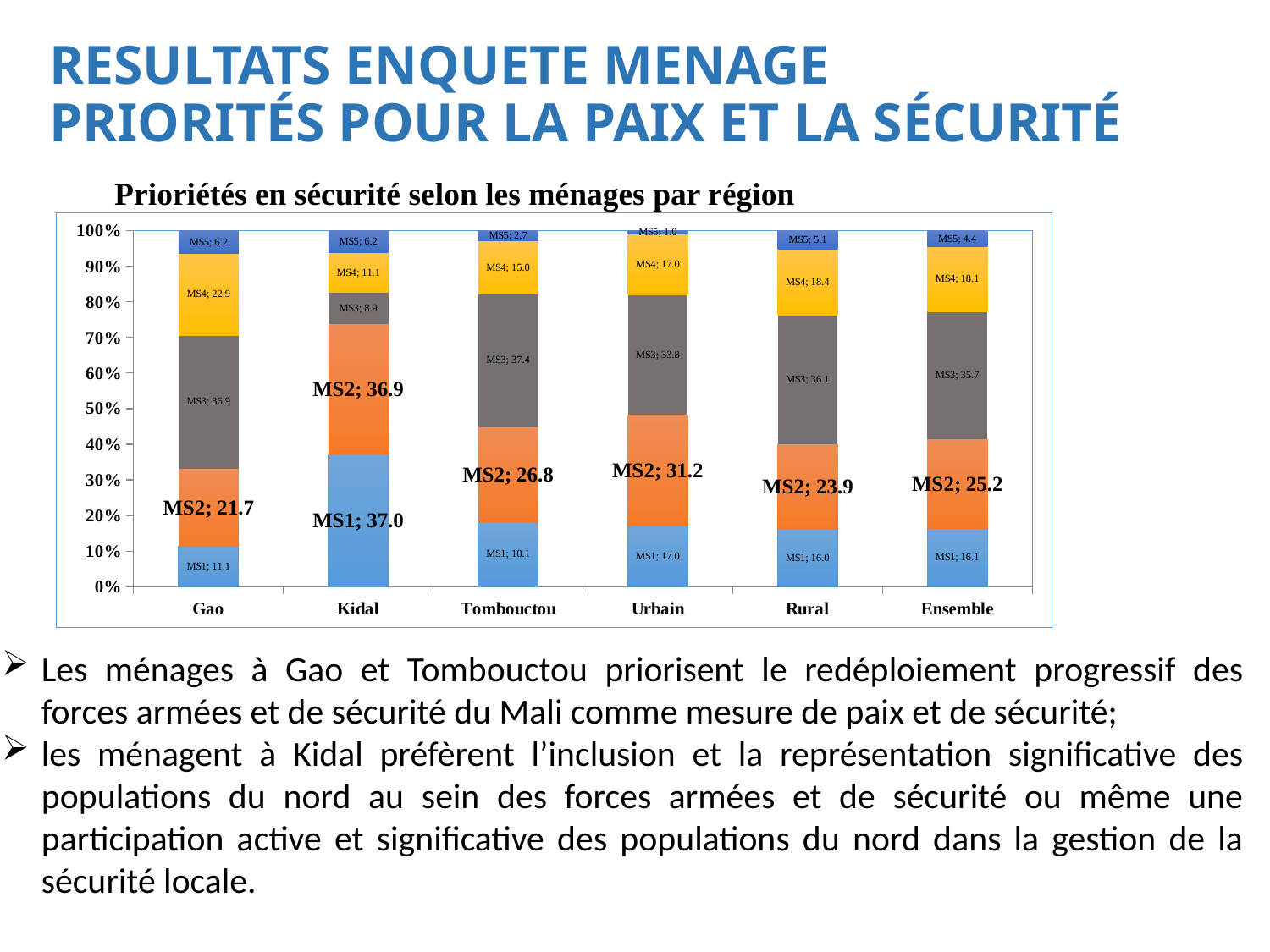
Which is larger, the MS4 value for Gao or the MS4 value for Kidal? Gao What is the MS5 value for Urbain? 1.0 Which category has the lowest MS5 value? Urbain How many categories are shown on the x axis? 6 What is the MS3 value for Tombouctou? 37.4 What is the MS1 value for Kidal? 37.0 What is the difference between the MS2 values for Urbain and Rural? 7.3 What is the MS4 value for Rural? 18.4 Which category has the highest MS2 value? Kidal What is the MS2 value for Gao? 21.7 Which category has the lowest MS1 value? Gao What is the title of the chart? Prioriétés en sécurité selon les ménages par région